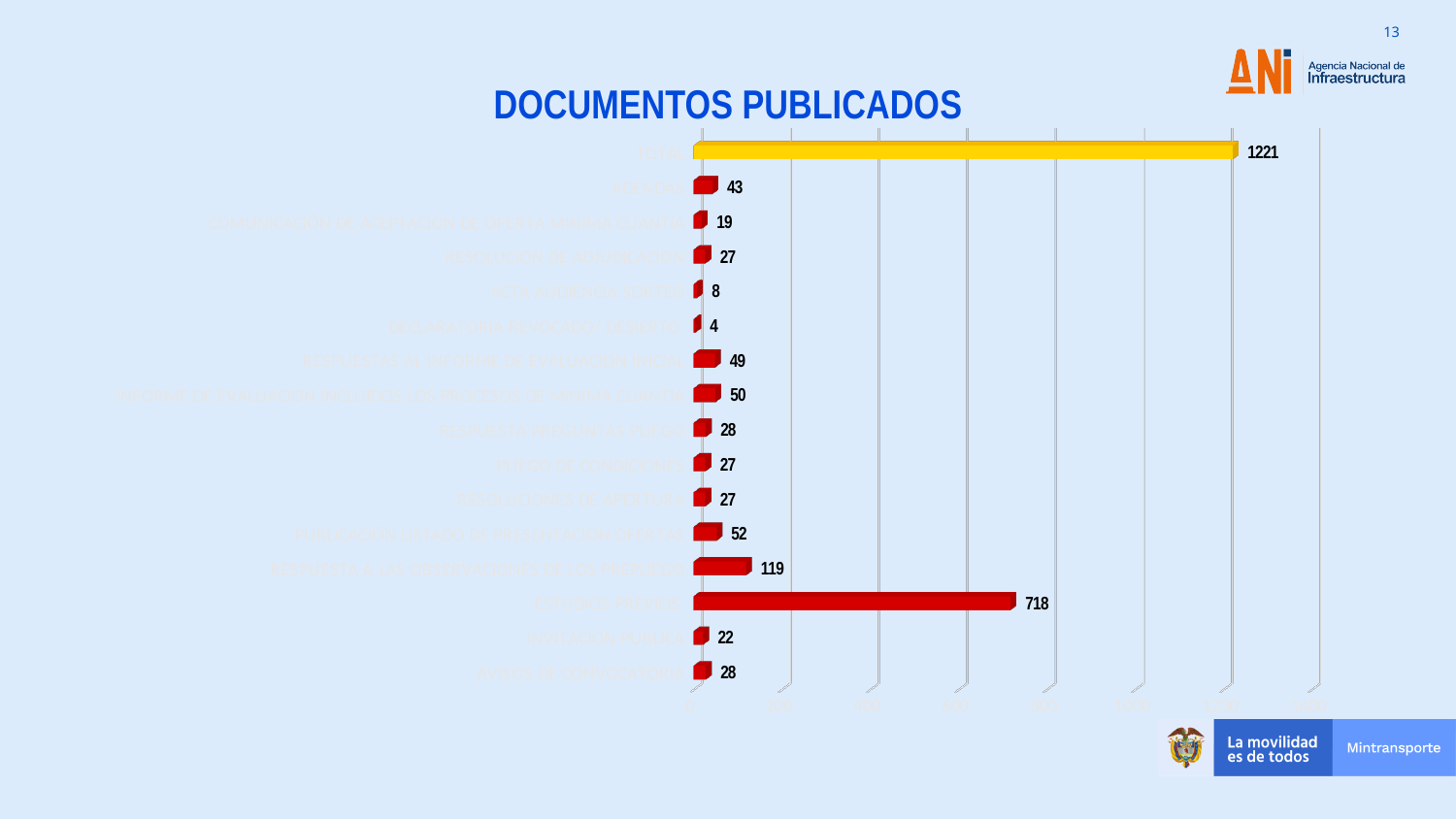
Which is larger: the bar labelled 119 or the bar labelled 52? 119 What is the highest value labelled on any bar in the chart? 1221 What is the difference between the topmost bar's value (1221) and the bar labelled 718? 503 What is the value shown on the bottom bar of the chart? 28 How many bars are plotted in the chart? 16 What is the value shown on the topmost bar of the chart? 1221 What kind of chart is shown on the slide? bar chart What colour is the topmost bar, which differs from the other bars? yellow What is the title of the chart? DOCUMENTOS PUBLICADOS What is the value shown on the second bar from the top? 43 What is the second-largest value labelled in the chart? 718 What is the lowest value labelled on any bar in the chart? 4